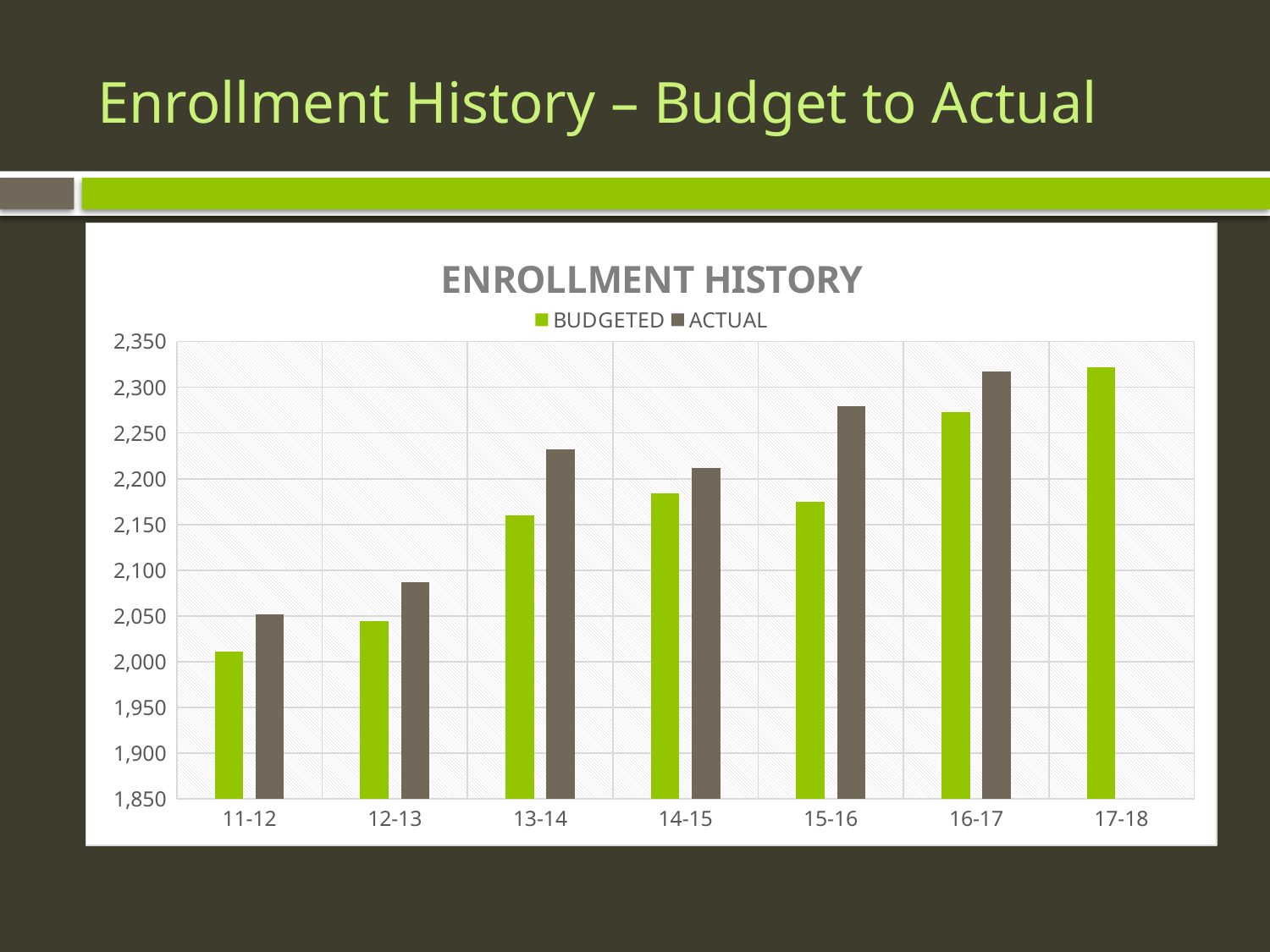
Which year has no ACTUAL bar shown? 17-18 Which year has the highest BUDGETED enrollment? 17-18 Is the BUDGETED value for 13-14 greater or less than 2,100? greater How many series does the legend list? 2 Which year has the lowest ACTUAL enrollment? 11-12 For 15-16, which is larger, BUDGETED or ACTUAL enrollment? ACTUAL Which year has the highest ACTUAL enrollment? 16-17 Is the ACTUAL value for 11-12 greater or less than 2,100? less What kind of chart is shown on the slide? Bar chart Which year has the lowest BUDGETED enrollment? 11-12 Do the ACTUAL values rise or fall from 11-12 to 16-17? They generally rise, though 14-15 dips below 13-14 How many school-year categories are shown on the x axis? 7